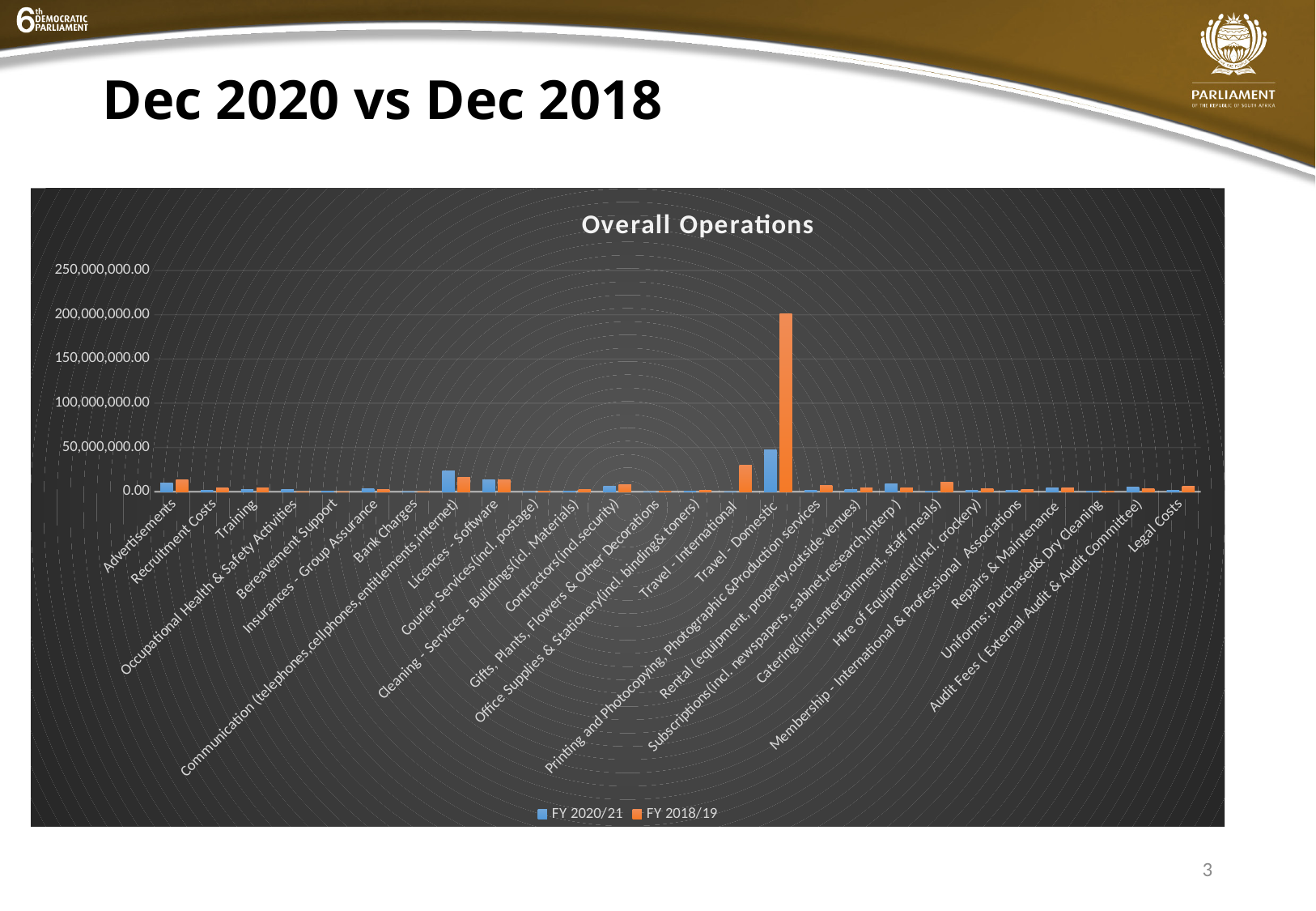
How many categories are shown on the x axis of the chart? 26 Is the FY 2018/19 value for Travel - Domestic greater or less than 150,000,000.00? greater Is the FY 2020/21 value for Travel - Domestic greater or less than 100,000,000.00? less Is the FY 2018/19 value for Travel - International greater or less than 50,000,000.00? less For Travel - Domestic, which series has the larger value, FY 2020/21 or FY 2018/19? FY 2018/19 What is the title of the chart? Overall Operations Which series is shown in orange in the chart? FY 2018/19 What type of chart is shown on the slide? Bar chart For Communication (telephones, cellphones, entitlements, internet), which series has the larger value, FY 2020/21 or FY 2018/19? FY 2020/21 Which category has the highest bar in the chart? Travel - Domestic How many series does the chart's legend list? 2 For Travel - International, which series has the larger value, FY 2020/21 or FY 2018/19? FY 2018/19